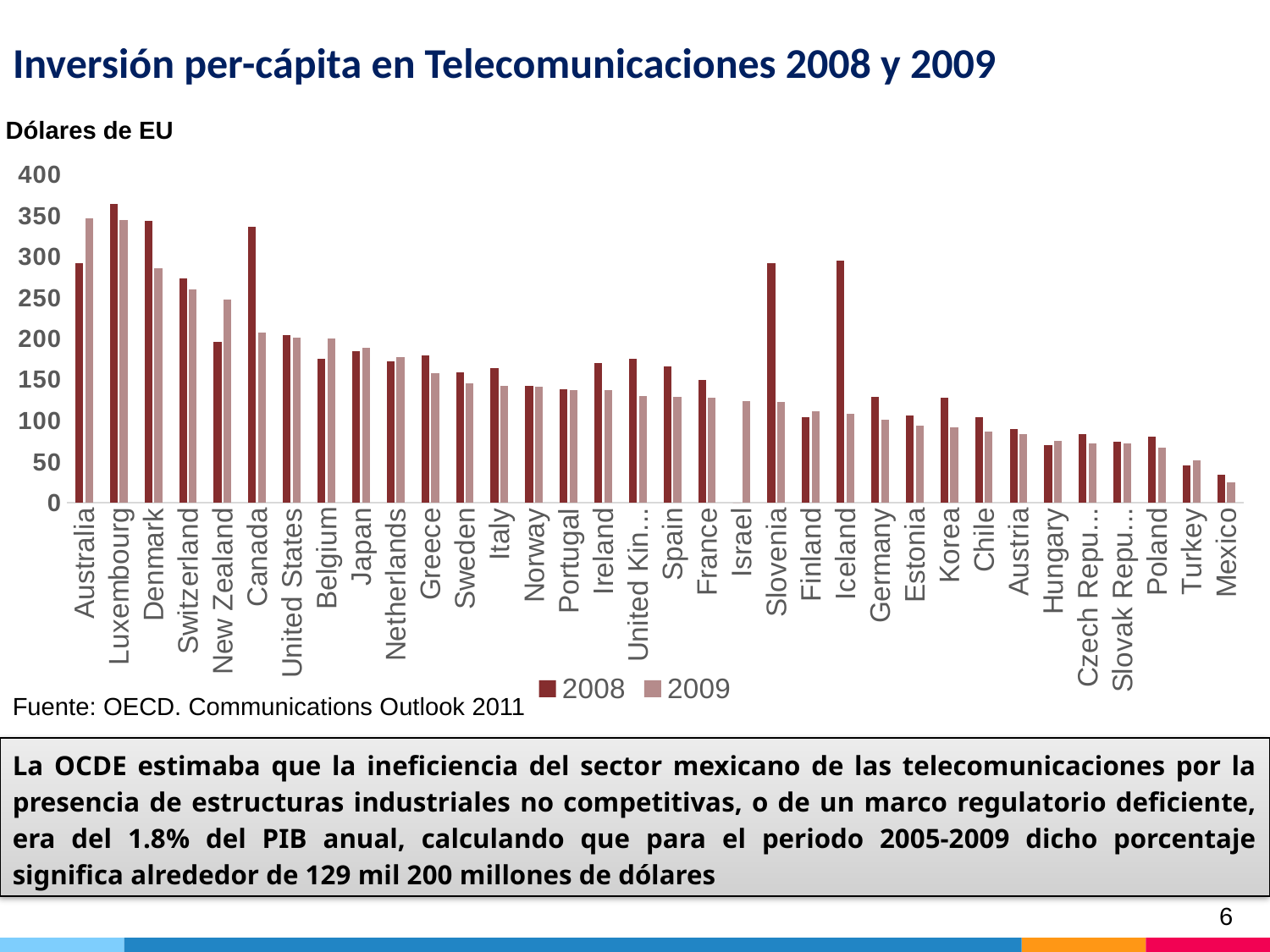
Which country has the lowest 2009 value? Mexico Which country has the lowest 2008 value? Mexico What kind of chart is shown on the slide? bar chart For Canada, which is larger, the 2008 value or the 2009 value? 2008 Is the 2008 value for Canada greater or less than 300? greater For New Zealand, which is larger, the 2008 value or the 2009 value? 2009 Which two series are listed in the legend? 2008 and 2009 Is the 2008 value for Mexico greater or less than 50? less Is the 2009 value for Israel greater or less than 100? greater How many countries are shown on the x axis? 34 Which country has the highest 2008 value? Luxembourg How many series does the legend list? 2